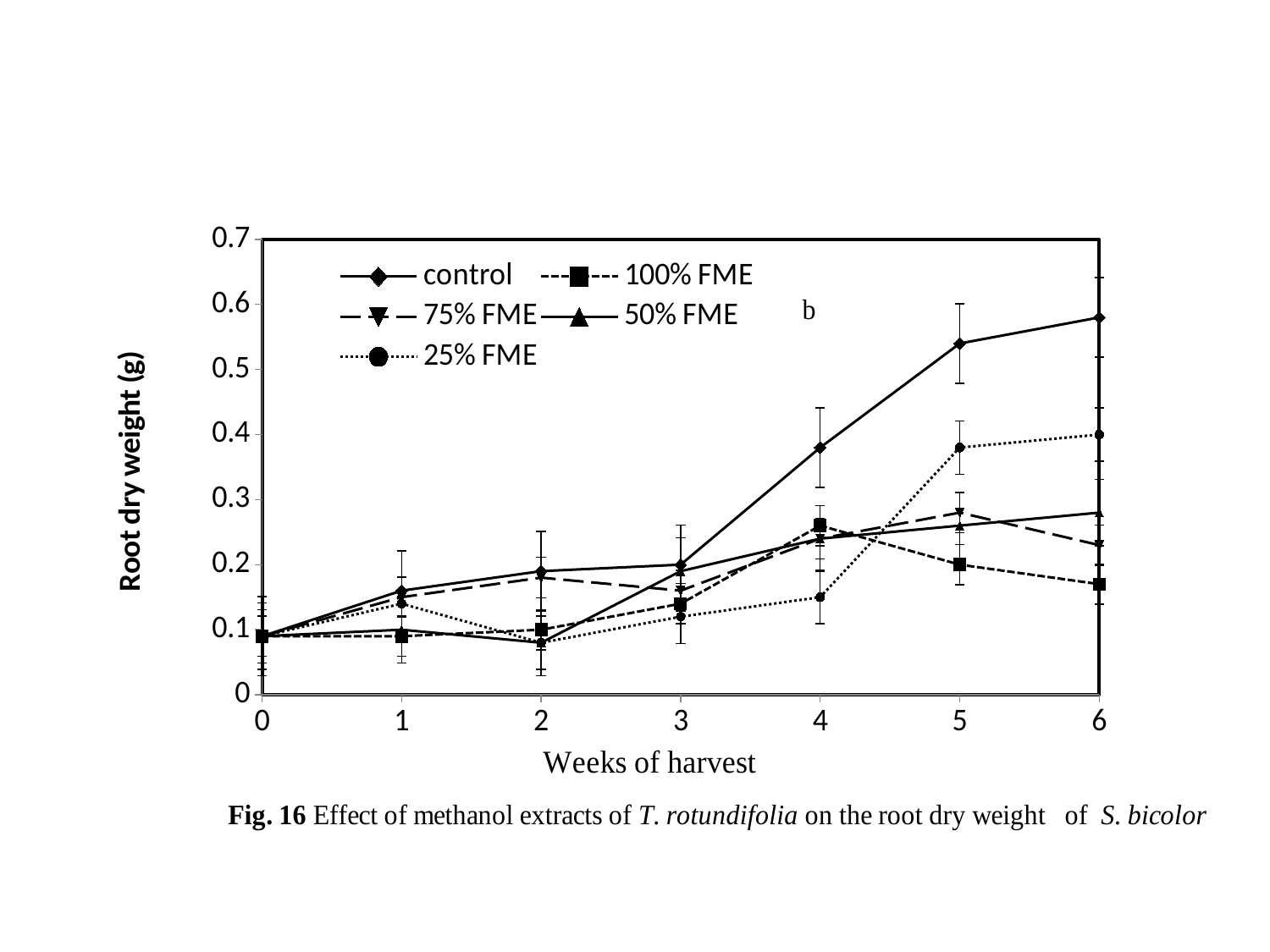
How many weeks of harvest are plotted along the x axis? 7 Which series has the highest root dry weight at week 6? control Does the control series rise or fall from week 0 to week 6? rise Is the value for 100% FME at week 6 greater or less than 0.2? less What is the title of the y axis? Root dry weight (g) Is the value for 25% FME at week 5 greater or less than 0.3? greater What is the title of the x axis? Weeks of harvest What kind of chart is shown on the slide? line chart Is the value for control at week 6 greater or less than 0.5? greater At week 4, which is larger: the value for control or the value for 25% FME? control How many series does the legend list? 5 Which series has the lowest root dry weight at week 6? 100% FME